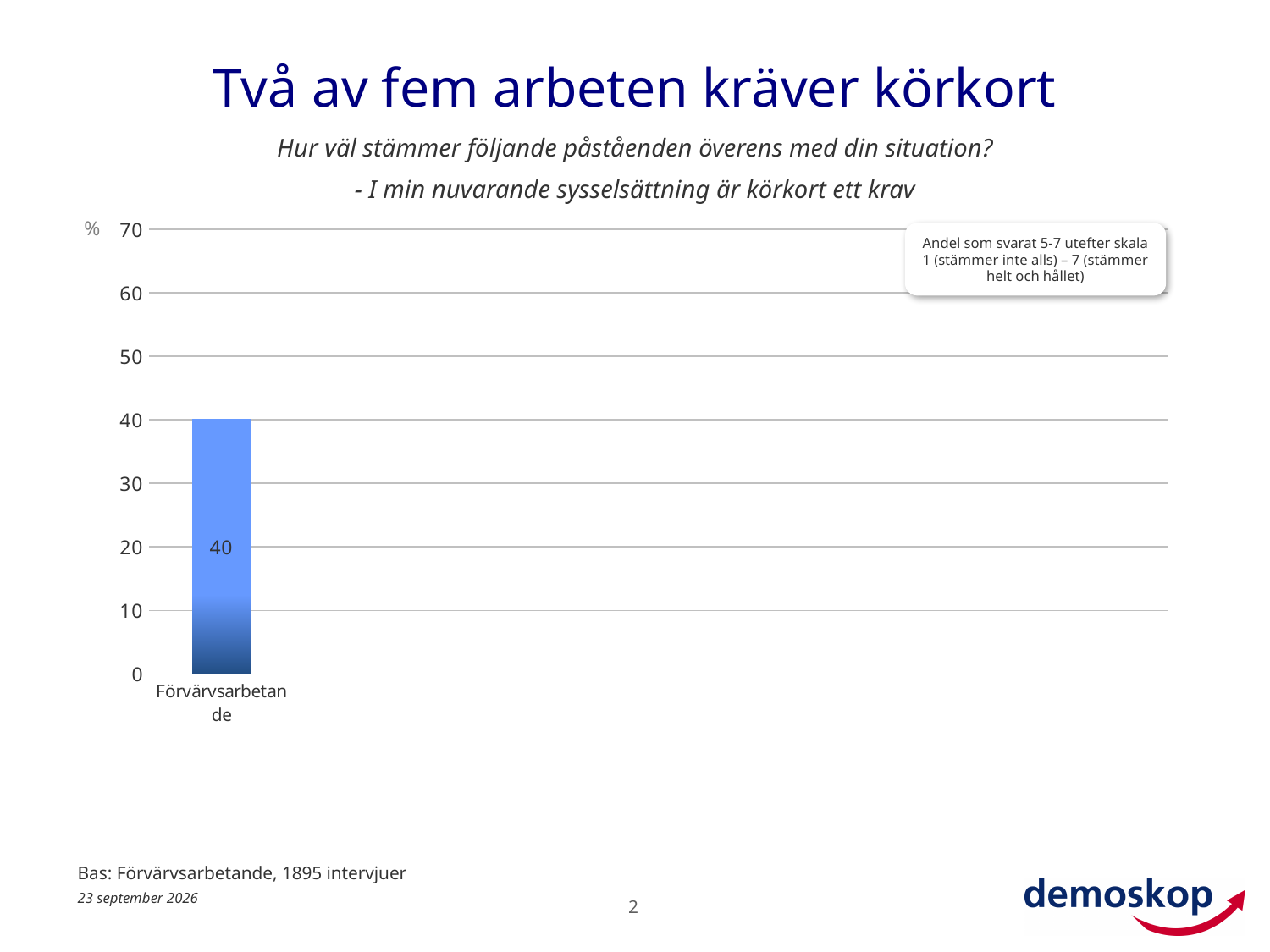
What is the value for Förvärvsarbetande? 40 What kind of chart is shown on the slide? bar chart What is the highest value shown on the vertical axis? 70 How many bars are plotted in the chart? 1 What is the title of the slide? Två av fem arbeten kräver körkort Is the value for Förvärvsarbetande greater or less than 30? greater Is the value for Förvärvsarbetande greater or less than 50? less What is the label of the only category on the x axis? Förvärvsarbetande